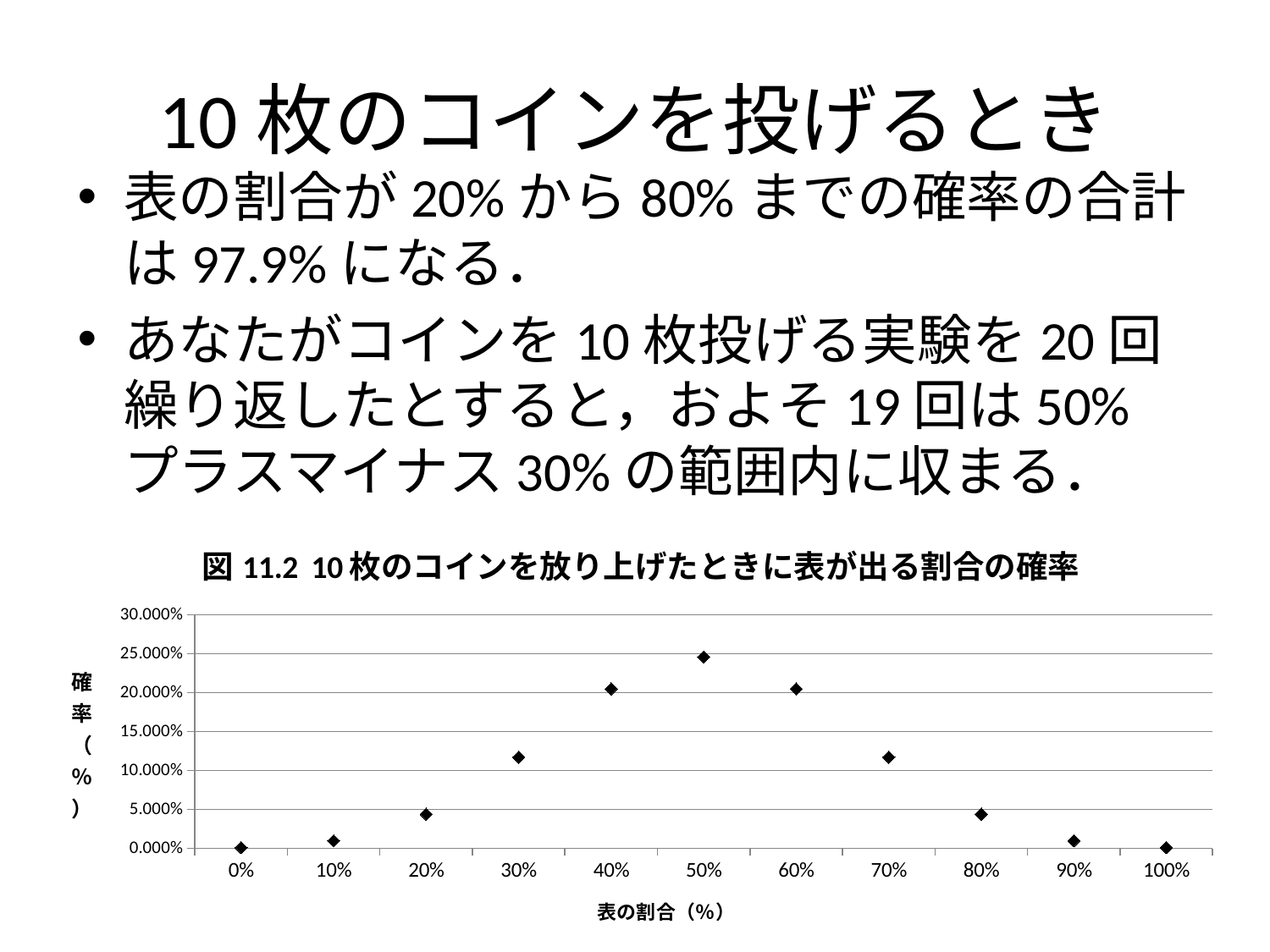
How do the probabilities change as 表の割合 increases from 0% to 100%? They rise up to 50%, then fall Which value of 表の割合 has the highest probability in the chart? 50% What kind of chart is shown on the slide? scatter chart Which has the higher probability: 表の割合 = 30% or 表の割合 = 20%? 30% How many data points are plotted in the chart? 11 What is the title of the chart? 図 11.2 10枚のコインを放り上げたときに表が出る割合の確率 Which has the higher probability: 表の割合 = 50% or 表の割合 = 40%? 50% Is the probability for 表の割合 = 30% greater or less than 10.000%? greater Is the probability for 表の割合 = 50% greater or less than 20.000%? greater